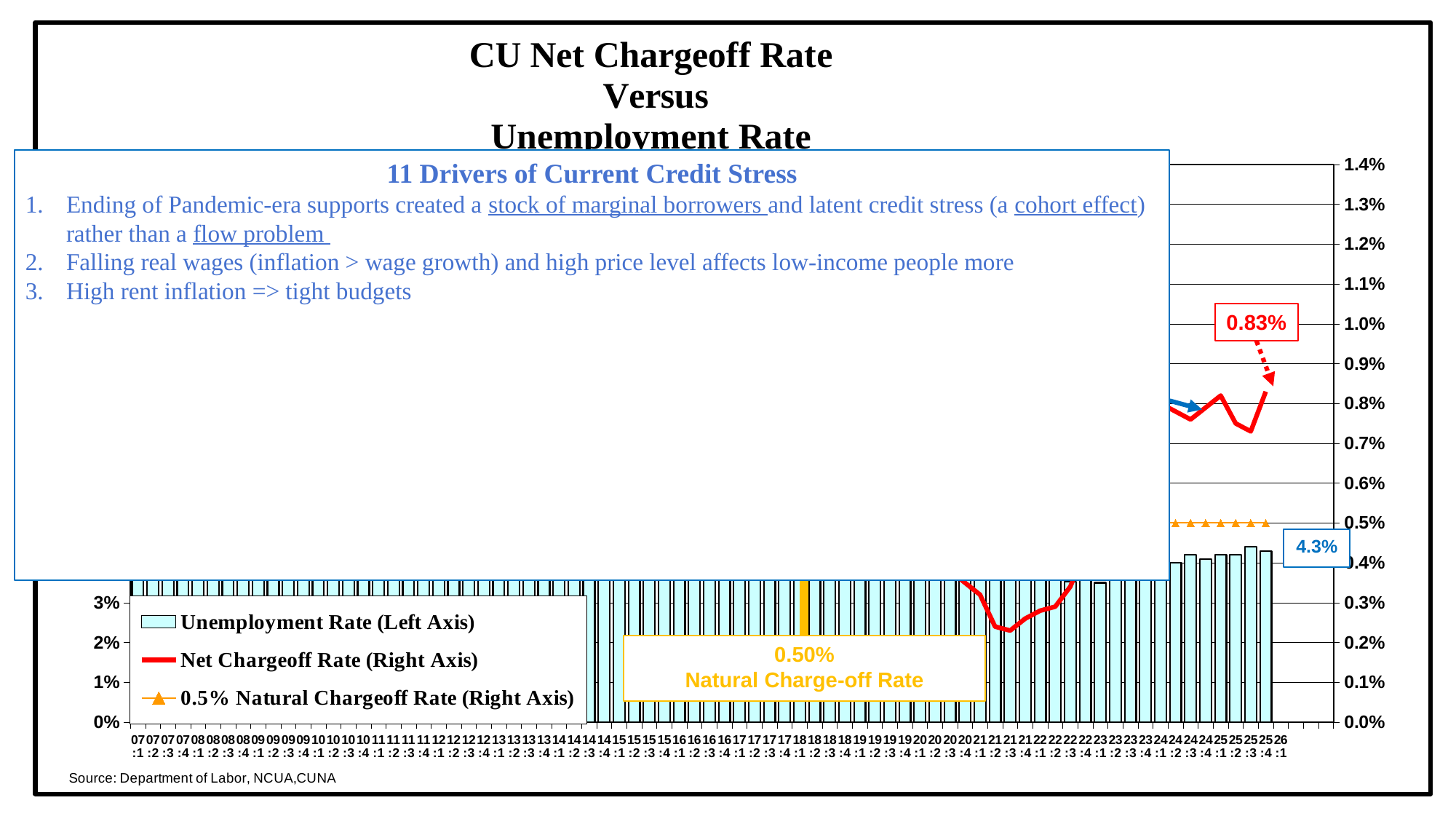
Is the projected Net Chargeoff Rate of 0.83% greater or less than the 0.50% Natural Charge-off Rate? greater What is the title of the chart? CU Net Chargeoff Rate Versus Unemployment Rate How many series does the chart legend list? 3 Does the Net Chargeoff Rate rise or fall from 2021 to 2022? rise Is the Net Chargeoff Rate at its low point around 2021 greater or less than 0.3%? less What is the difference between the projected Net Chargeoff Rate of 0.83% and the 0.50% Natural Charge-off Rate? 0.33% Which axis is the Unemployment Rate plotted on, according to the legend? Left Axis What is the highest value shown on the right-hand axis? 1.4% What value is shown in the red data label for the Net Chargeoff Rate? 0.83% What is the value of the Natural Charge-off Rate line? 0.50% What kind of chart is this? Combination bar and line chart What value is shown in the blue data label for the Unemployment Rate at the end of the series? 4.3%